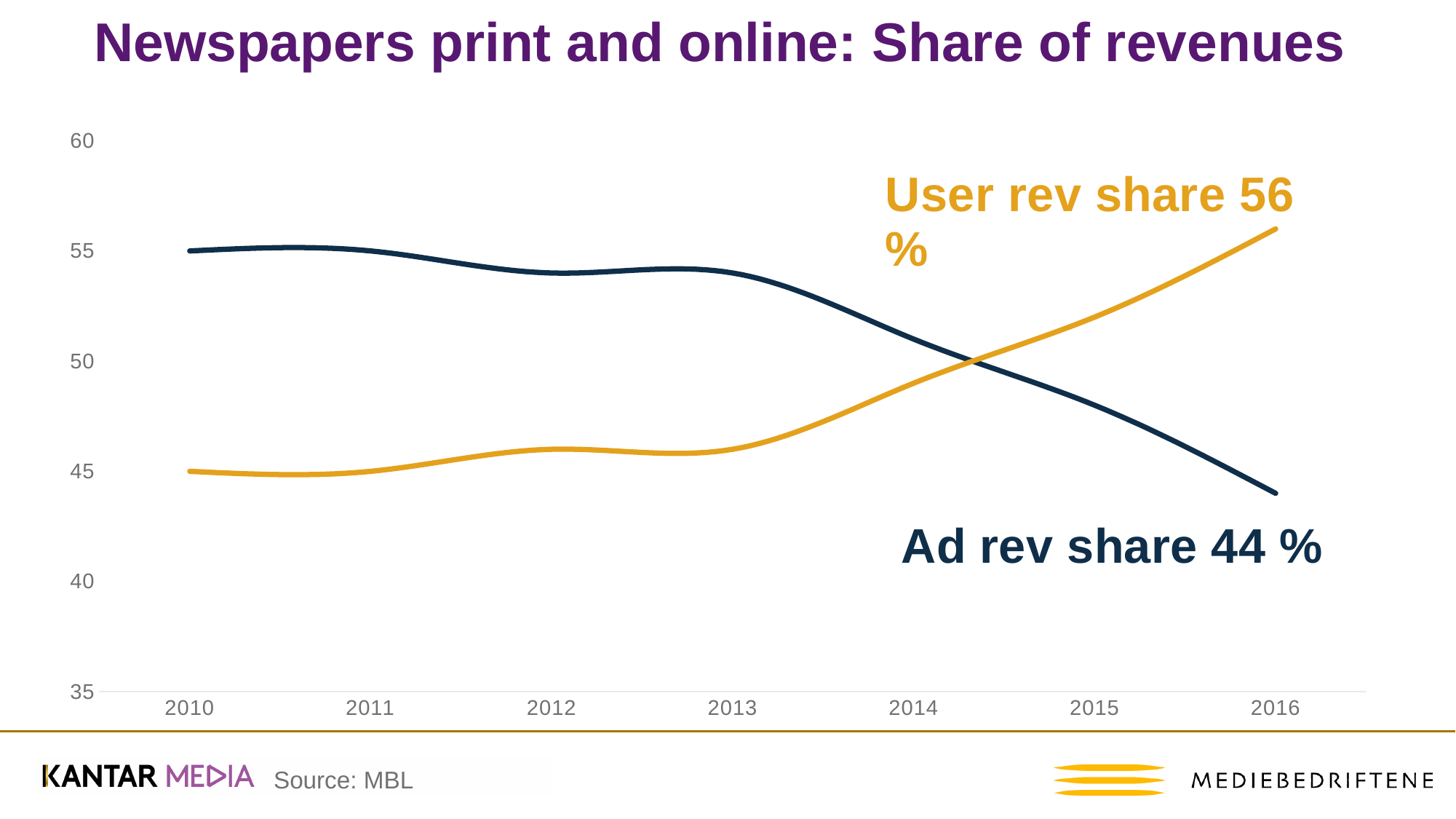
What is the user revenue share in 2016? 56 % Is the ad revenue share in 2013 greater or less than 50? greater How many series are plotted on the chart? 2 Does the ad revenue share rise or fall from 2010 to 2016? Fall In 2016, which is larger: the user revenue share or the ad revenue share? User rev share What is the ad revenue share in 2016? 44 % Is the user revenue share in 2012 greater or less than 50? less What kind of chart is shown on the slide? Line chart What is the title of the chart? Newspapers print and online: Share of revenues How many years are shown on the x axis? 7 Does the user revenue share rise or fall from 2010 to 2016? Rise What is the difference between the user revenue share and the ad revenue share in 2016? 12 percentage points